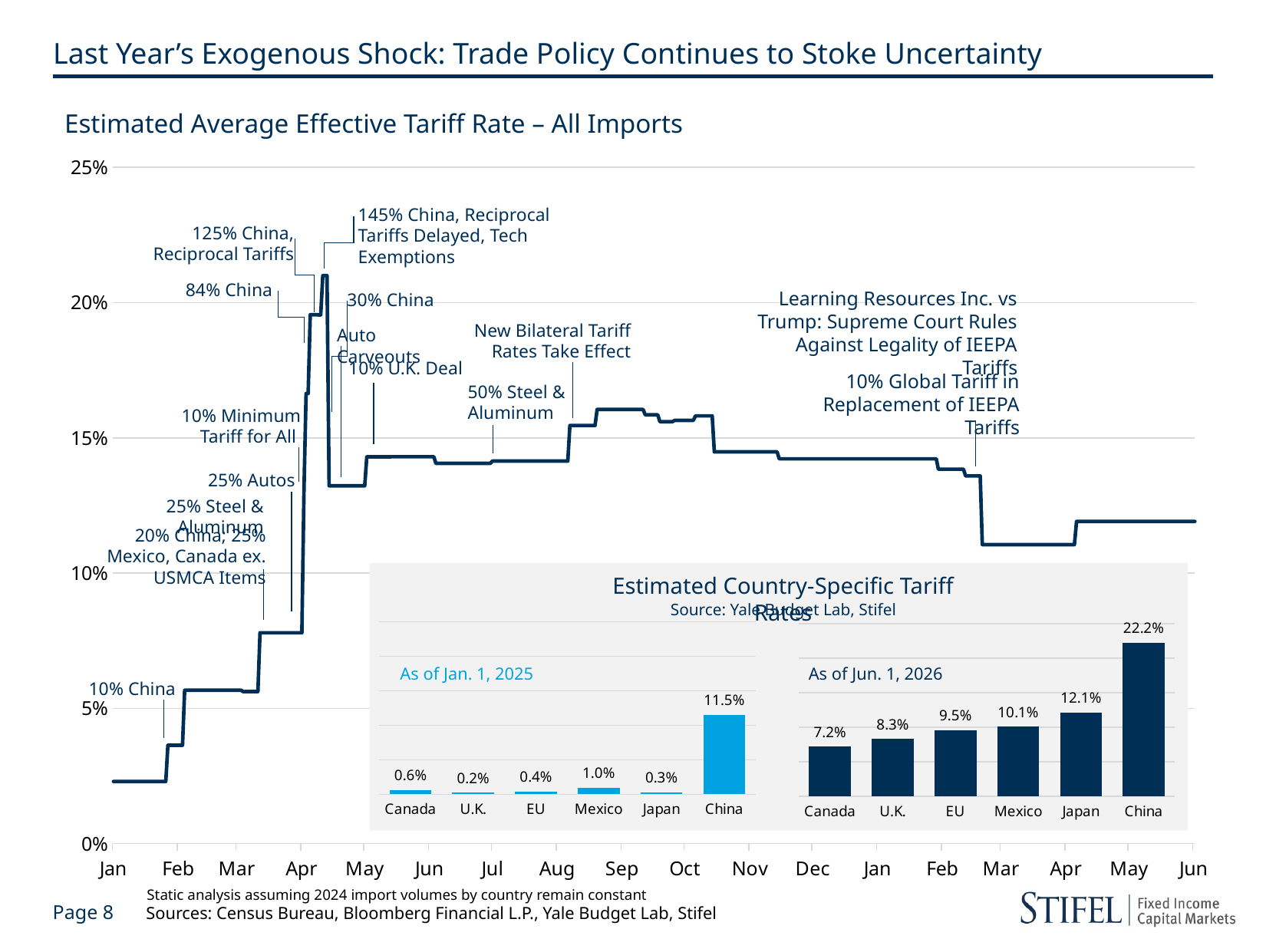
In the Estimated Country-Specific Tariff Rates chart, what is the tariff rate for China as of Jun. 1, 2026? 22.2% In the Estimated Country-Specific Tariff Rates chart, what is the tariff rate for Mexico as of Jan. 1, 2025? 1.0% In the Estimated Country-Specific Tariff Rates chart, which country has the highest tariff rate as of Jun. 1, 2026? China In the Estimated Country-Specific Tariff Rates chart, which country has the lowest tariff rate as of Jan. 1, 2025? U.K. In the Estimated Country-Specific Tariff Rates chart, as of Jun. 1, 2026, which is larger: the tariff rate for the EU or for the U.K.? EU In the Estimated Average Effective Tariff Rate – All Imports chart, is the value at the start in January greater or less than 5%? less What kind of chart is the Estimated Average Effective Tariff Rate – All Imports chart? line chart In the Estimated Country-Specific Tariff Rates chart, what is the difference between China's tariff rate as of Jun. 1, 2026 and as of Jan. 1, 2025? 10.7% In the Estimated Country-Specific Tariff Rates chart, what is the difference between Japan's and Canada's tariff rates as of Jun. 1, 2026? 4.9% How many countries are shown in each panel of the Estimated Country-Specific Tariff Rates chart? 6 In the Estimated Average Effective Tariff Rate – All Imports chart, is the peak value in April greater or less than 20%? greater In the Estimated Country-Specific Tariff Rates chart, do the values as of Jun. 1, 2026 rise or fall from Canada to China? rise